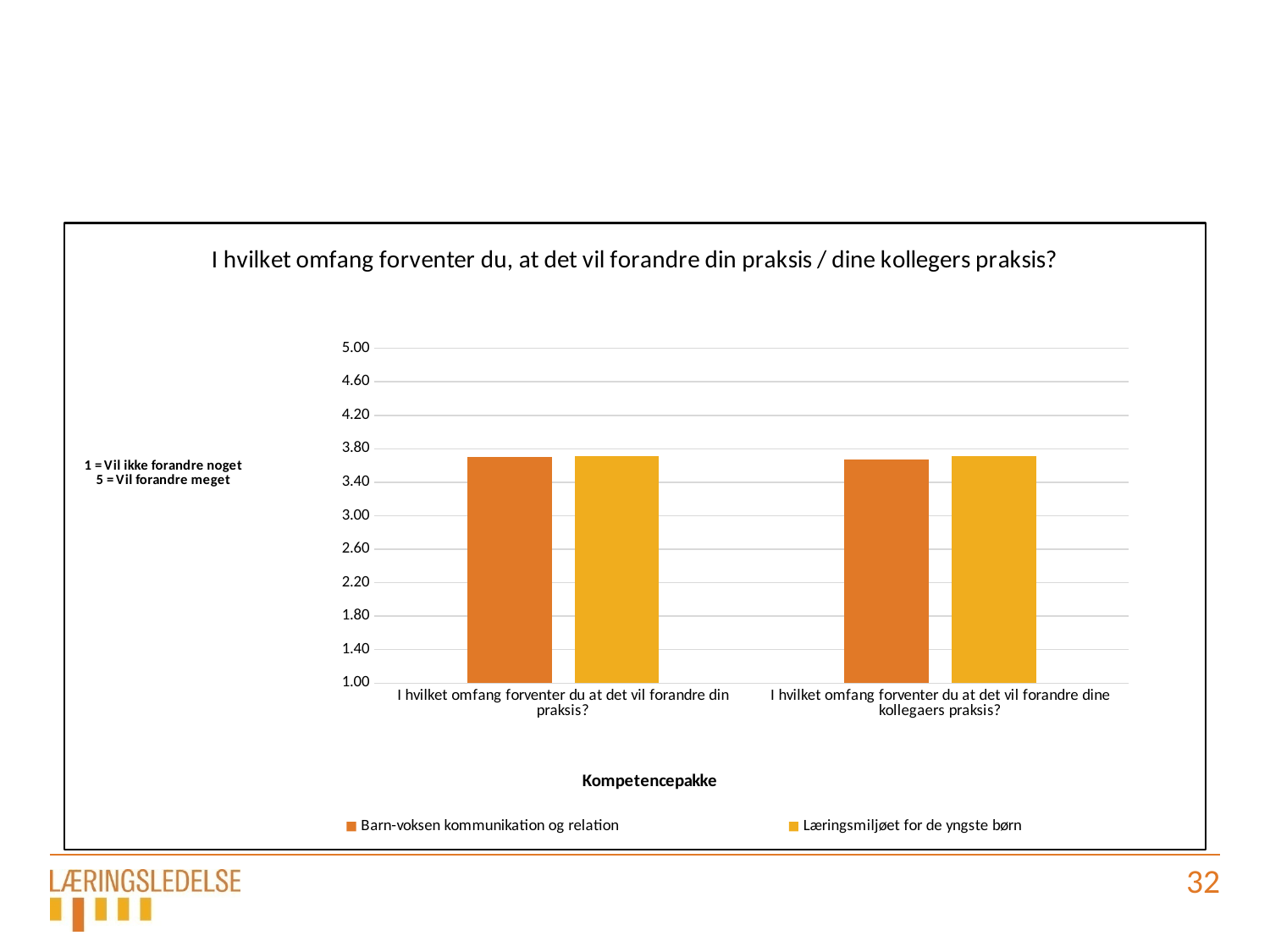
Is the value for 'Læringsmiljøet for de yngste børn' in the category 'I hvilket omfang forventer du at det vil forandre dine kollegaers praksis?' greater or less than 3.80? less Is the value for 'Læringsmiljøet for de yngste børn' in the category 'I hvilket omfang forventer du at det vil forandre dine kollegaers praksis?' greater or less than 3.40? greater Is the value for 'Læringsmiljøet for de yngste børn' in the category 'I hvilket omfang forventer du at det vil forandre din praksis?' greater or less than 4.20? less What kind of chart is shown on the slide? bar chart How many series does the chart's legend list? 2 What is the title of the chart? I hvilket omfang forventer du, at det vil forandre din praksis / dine kollegers praksis? What is the label shown below the x axis of the chart? Kompetencepakke How many categories are shown on the x axis of the chart? 2